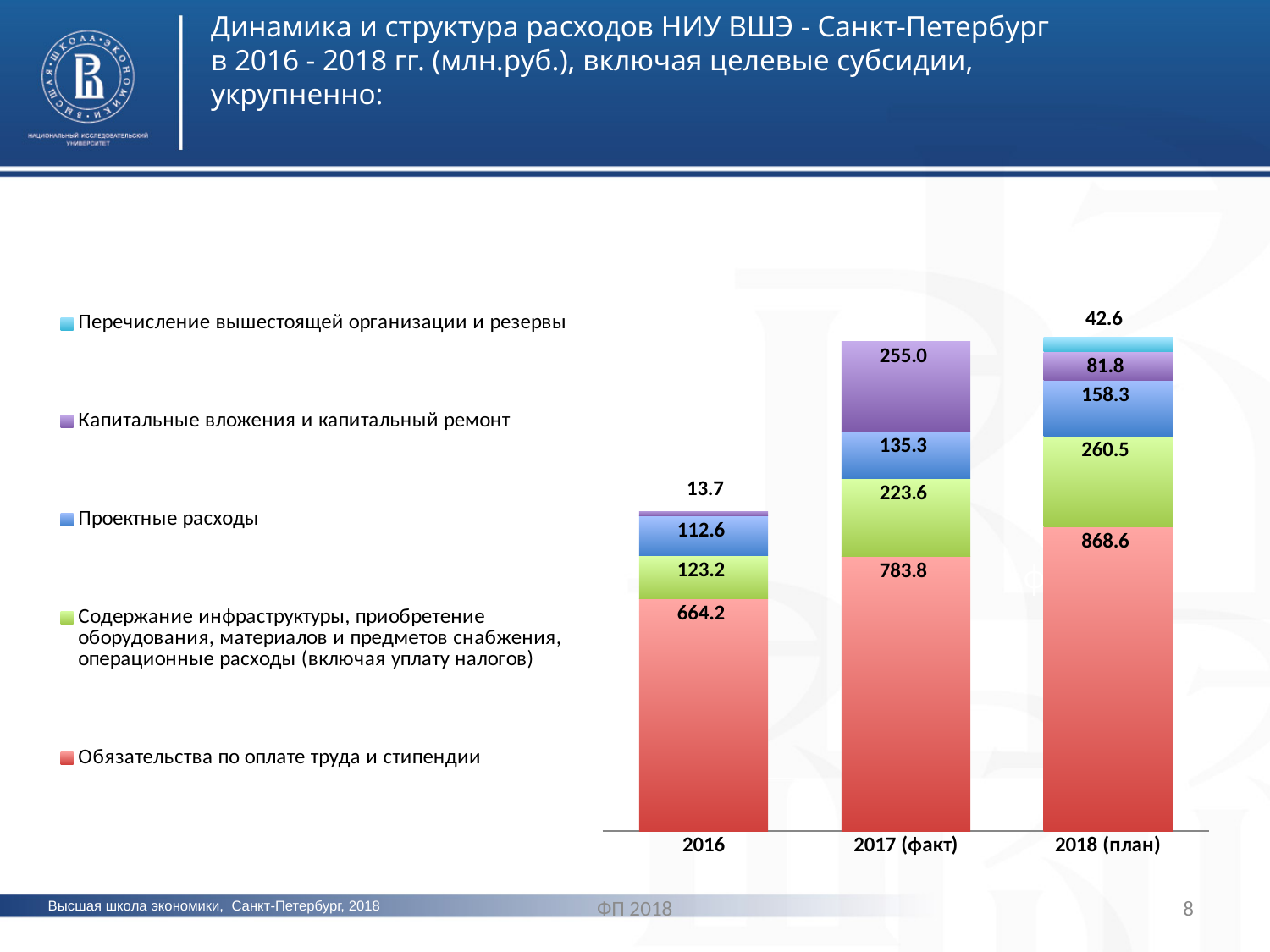
What is the difference between the 2018 (план) and 2016 values for Обязательства по оплате труда и стипендии? 204.4 What is the value for Проектные расходы in 2017 (факт)? 135.3 What is the value for Капитальные вложения и капитальный ремонт in 2017 (факт)? 255.0 What is the total of the 2018 (план) stacked bar? 1411.8 Does the value for Обязательства по оплате труда и стипендии rise or fall from 2016 to 2018 (план)? rise What is the difference between the 2017 (факт) and 2018 (план) values for Капитальные вложения и капитальный ремонт? 173.2 In which year is the value for Обязательства по оплате труда и стипендии the highest? 2018 (план) How many series does the legend list? 5 Which is larger: Содержание инфраструктуры in 2017 (факт) or Проектные расходы in 2018 (план)? Содержание инфраструктуры in 2017 (факт) What is the value for Обязательства по оплате труда и стипендии in 2016? 664.2 What is the value for Перечисление вышестоящей организации и резервы in 2018 (план)? 42.6 In which year is the value for Капитальные вложения и капитальный ремонт the lowest? 2016